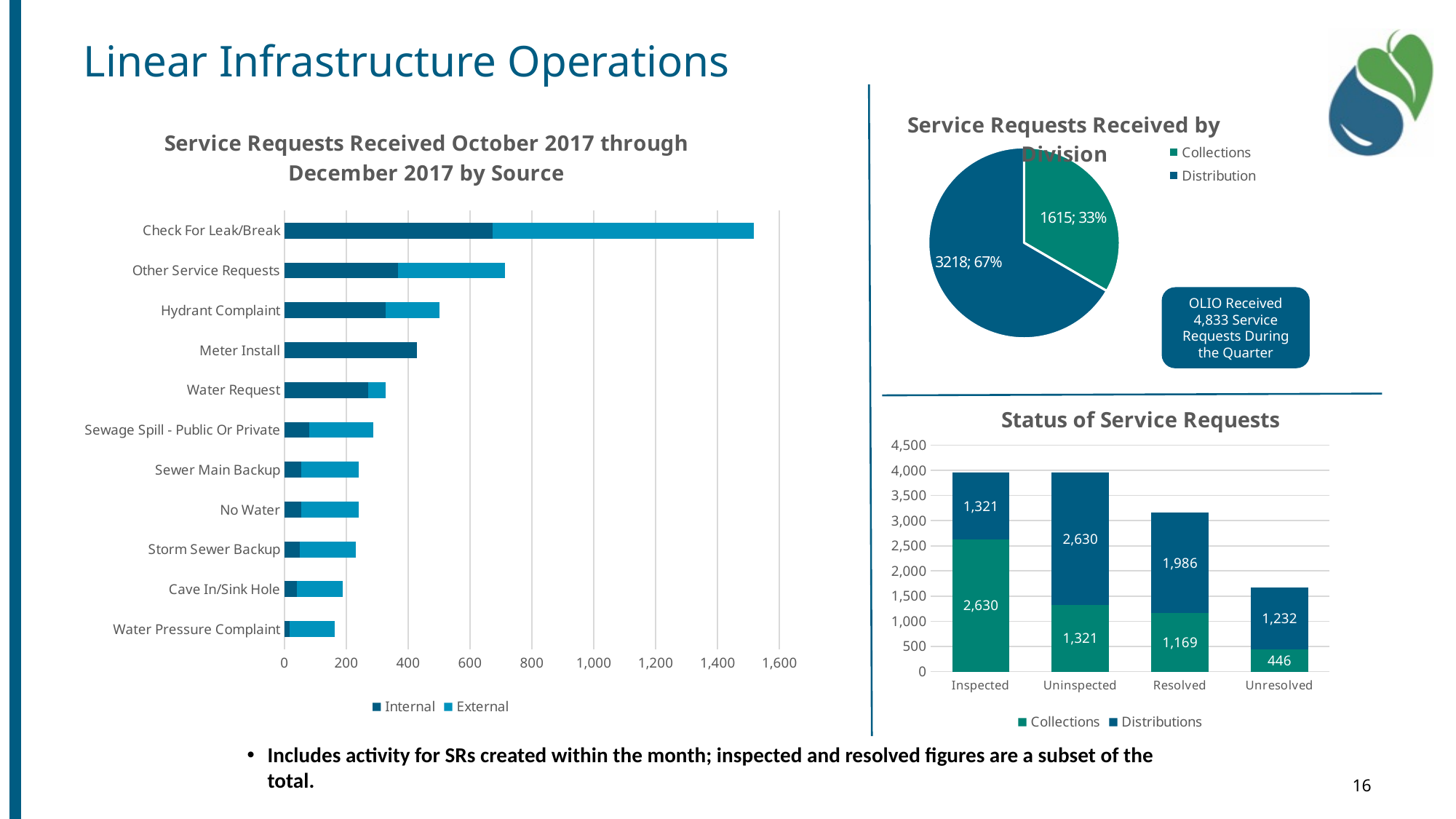
How many categories are shown on the 'Service Requests Received October 2017 through December 2017 by Source' chart? 11 On the 'Service Requests Received October 2017 through December 2017 by Source' chart, which category has the longest bar? Check For Leak/Break On the 'Status of Service Requests' chart, what is the difference between the Distributions and Collections values for Resolved? 817 On the 'Status of Service Requests' chart, what is the Distributions value for Unresolved? 1,232 On the 'Status of Service Requests' chart, how many series does the legend list? 2 On the 'Service Requests Received by Division' pie chart, what share of service requests came from Distribution? 67% On the 'Status of Service Requests' chart, what is the total of the Unresolved bar? 1,678 On the 'Status of Service Requests' chart, what is the Collections value for Resolved? 1,169 On the 'Service Requests Received by Division' pie chart, what value is shown for Collections? 1615; 33% On the 'Service Requests Received October 2017 through December 2017 by Source' chart, is the total value for Check For Leak/Break greater or less than 1,400? greater On the 'Service Requests Received by Division' pie chart, which division received more service requests? Distribution What kind of chart is 'Service Requests Received October 2017 through December 2017 by Source'? Bar chart